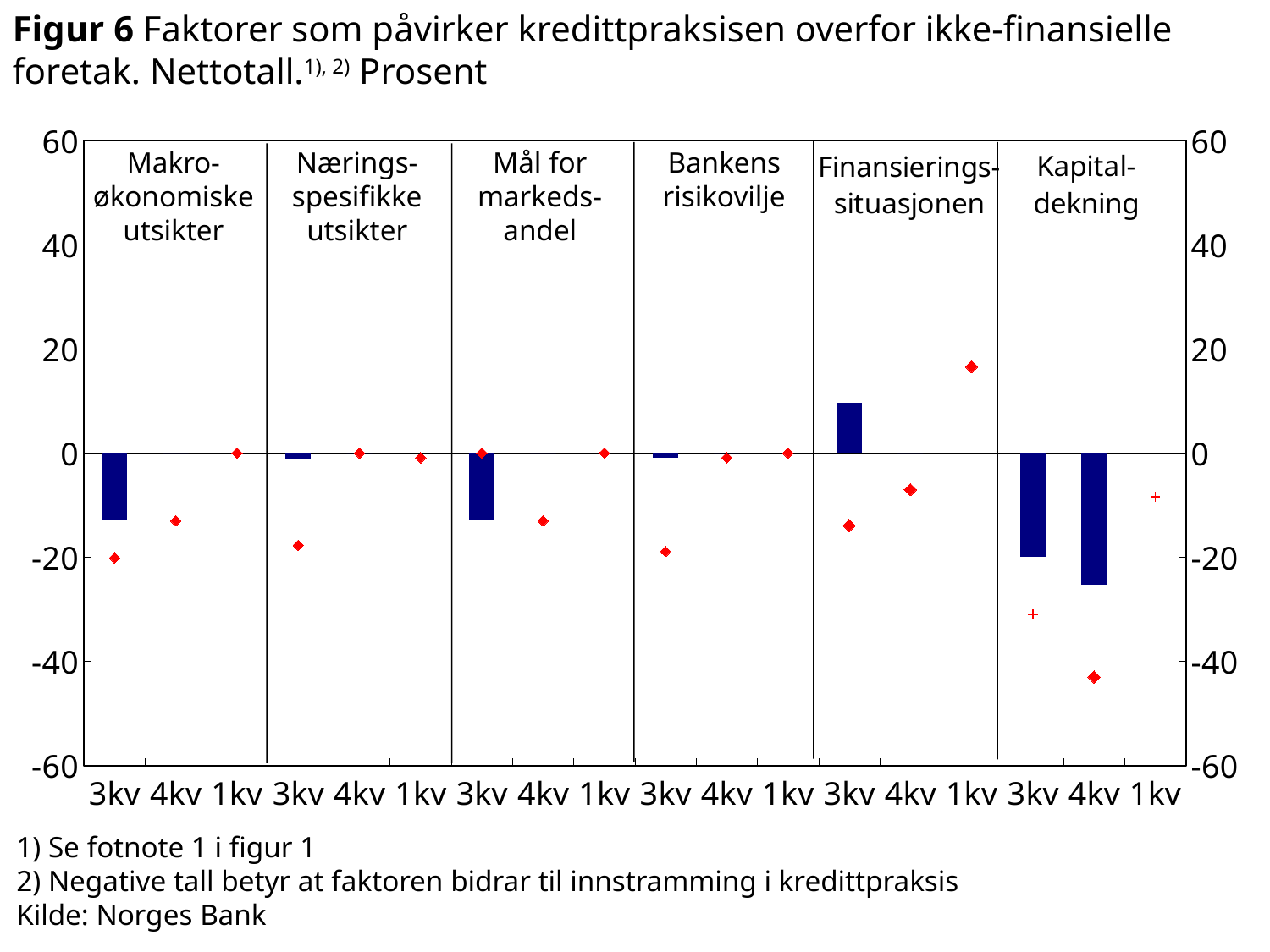
Which factor is the only one with a positive (upward) bar? Finansieringssituasjonen Within Kapitaldekning, which bar is lower, 3kv or 4kv? 4kv Is the 3kv bar for Finansieringssituasjonen greater or less than 0? greater What kind of chart is shown in Figur 6? combination bar and line chart (bars with red markers) Is the 4kv bar for Kapitaldekning greater or less than -20? less Is the 3kv bar for Makroøkonomiske utsikter greater or less than -20? greater How many quarters (3kv, 4kv, 1kv) are shown within each factor panel? 3 What source is cited for the chart? Norges Bank How many factors (panels) are shown along the x axis of the chart? 6 Which factor has the lowest (most negative) bar in the chart? Kapitaldekning